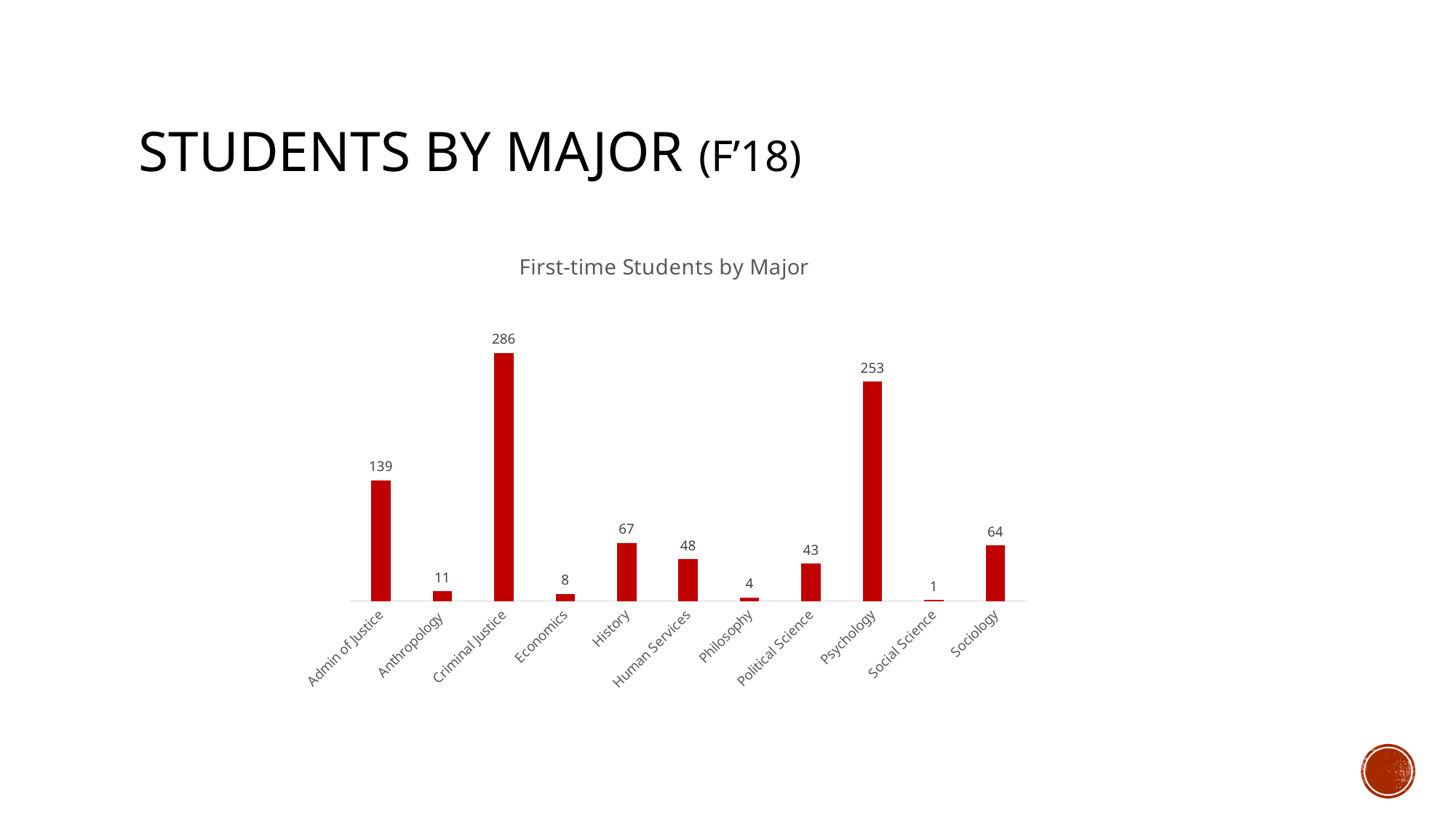
What is the difference between the values for Criminal Justice and Psychology? 33 Which major has the lowest number of first-time students? Social Science What colour are the bars in the chart? Red How many majors are shown on the x axis? 11 What is the value for Criminal Justice? 286 What is the value for Human Services? 48 What is the title of the chart? First-time Students by Major What is the difference between the values for Admin of Justice and Sociology? 75 Which major has the highest number of first-time students? Criminal Justice What is the value for Psychology? 253 What kind of chart is shown on the slide? Bar chart Which is larger, the value for History or the value for Political Science? History